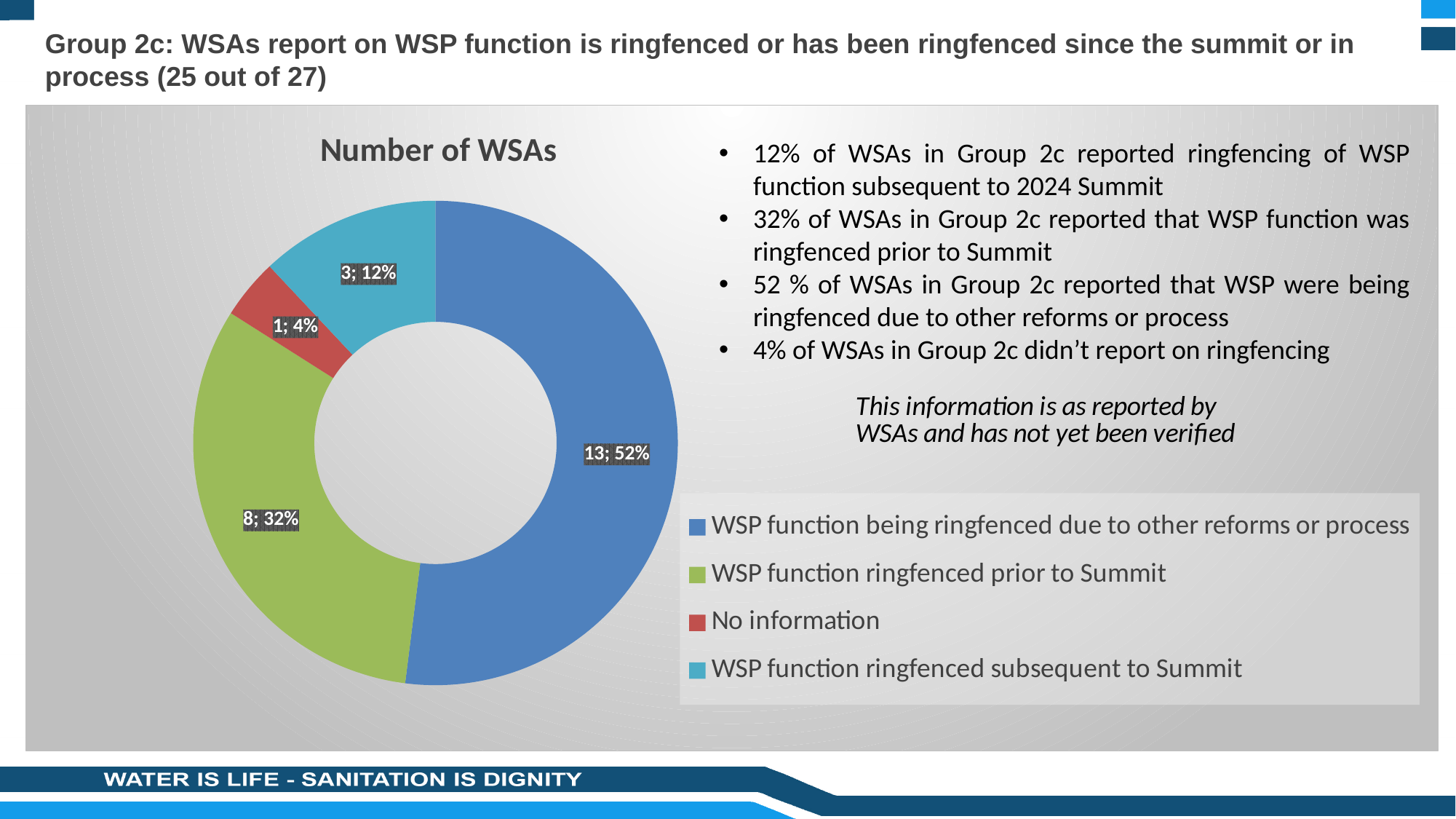
What share of the pie does 'WSP function ringfenced prior to Summit' represent? 32% Which category has the largest slice of the pie? WSP function being ringfenced due to other reforms or process What is the title of the chart? Number of WSAs How many WSAs reported that the WSP function was ringfenced subsequent to the Summit? 3 Which is larger: the number of WSAs with WSP function ringfenced subsequent to the Summit or the number with no information? WSP function ringfenced subsequent to Summit What kind of chart is shown on the slide? Pie chart (doughnut) How many WSAs reported that the WSP function was ringfenced prior to the Summit? 8 Which category has the smallest slice of the pie? No information What share of the pie does 'No information' represent? 4% What is the difference in the number of WSAs between 'WSP function being ringfenced due to other reforms or process' and 'WSP function ringfenced prior to Summit'? 5 How many categories does the legend list? 4 How many WSAs reported that the WSP function is being ringfenced due to other reforms or process? 13